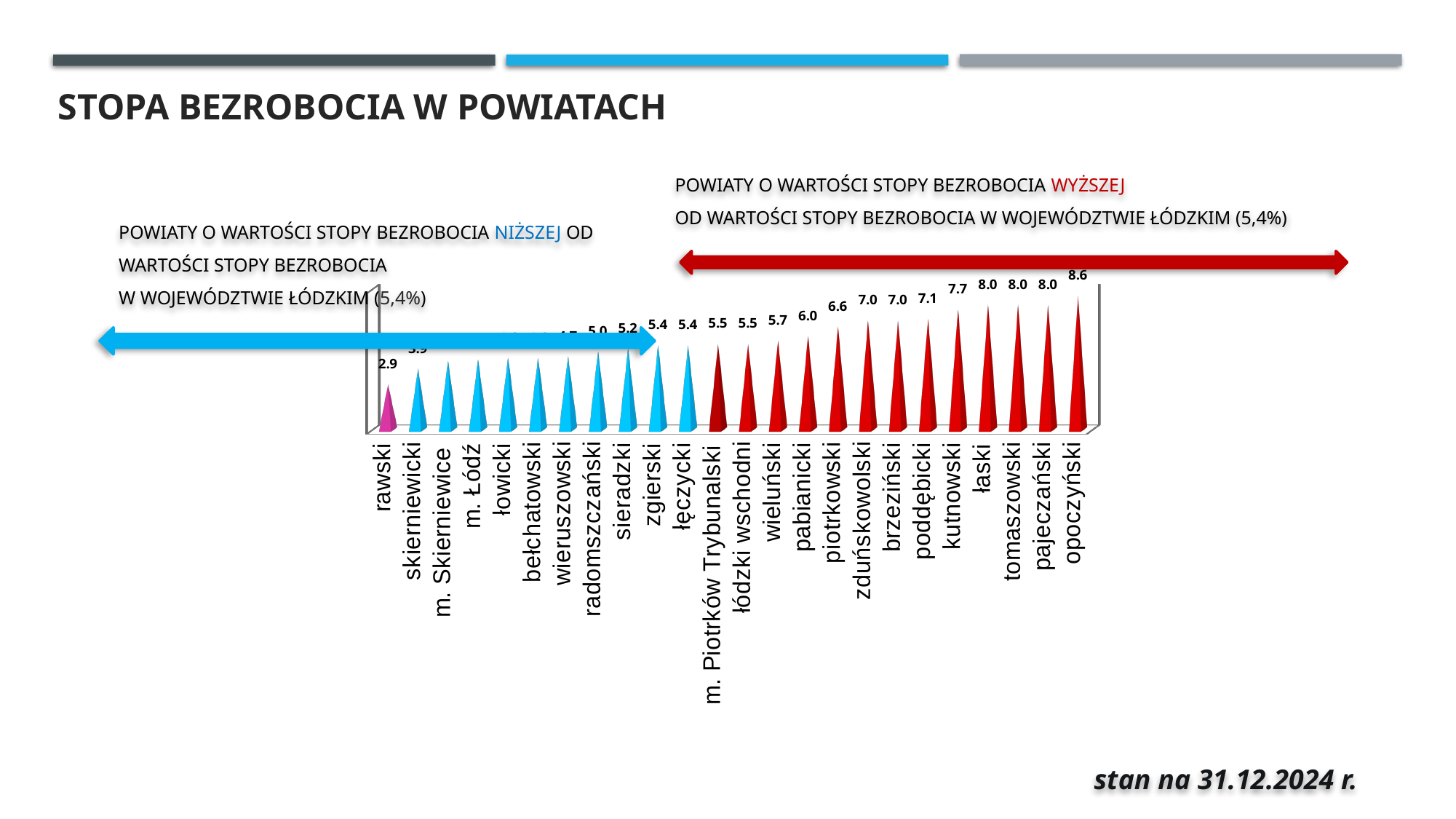
What is the value shown for rawski? 2.9 What kind of chart is shown on the slide? bar chart What is the title of the slide? STOPA BEZROBOCIA W POWIATACH What is the value shown for kutnowski? 7.7 What is the value shown for pabianicki? 6.0 What is the unemployment rate value shown for opoczyński? 8.6 Which has a higher value, piotrkowski or wieluński? piotrkowski What is the difference between the values for opoczyński and rawski? 5.7 Do the values rise or fall moving from left to right along the x axis? rise Which powiat has the lowest unemployment rate on the chart? rawski Which powiat has the highest unemployment rate on the chart? opoczyński How many powiats (categories) are shown on the x axis of the chart? 24